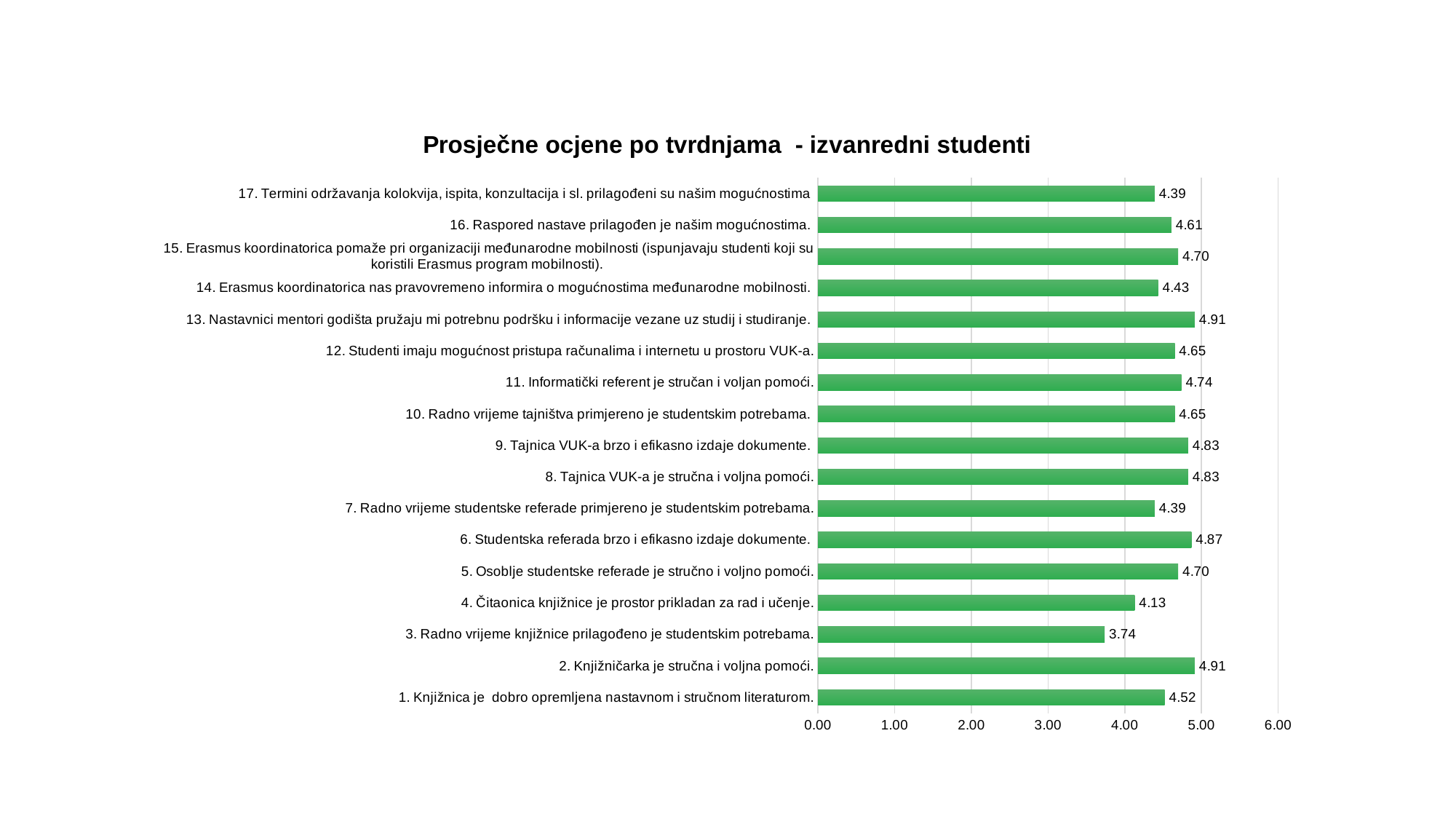
What is the average score for statement 4, "Čitaonica knjižnice je prostor prikladan za rad i učenje"? 4.13 What is the highest average score shown on the chart? 4.91 Which has a higher average score: statement 11 (Informatički referent) or statement 12 (pristup računalima)? Statement 11 What is the average score for statement 6, "Studentska referada brzo i efikasno izdaje dokumente"? 4.87 How many statements are shown on the chart? 17 Is the average score for statement 1, "Knjižnica je dobro opremljena nastavnom i stručnom literaturom", greater or less than 4.00? greater What is the average score for statement 3, "Radno vrijeme knjižnice prilagođeno je studentskim potrebama"? 3.74 What type of chart is shown on the slide? Bar chart What is the difference between the average scores for statement 13 (4.91) and statement 3 (3.74)? 1.17 What is the title of the chart? Prosječne ocjene po tvrdnjama - izvanredni studenti What is the difference between the average scores for statement 16 and statement 17? 0.22 Which statement has the lowest average score? 3. Radno vrijeme knjižnice prilagođeno je studentskim potrebama.